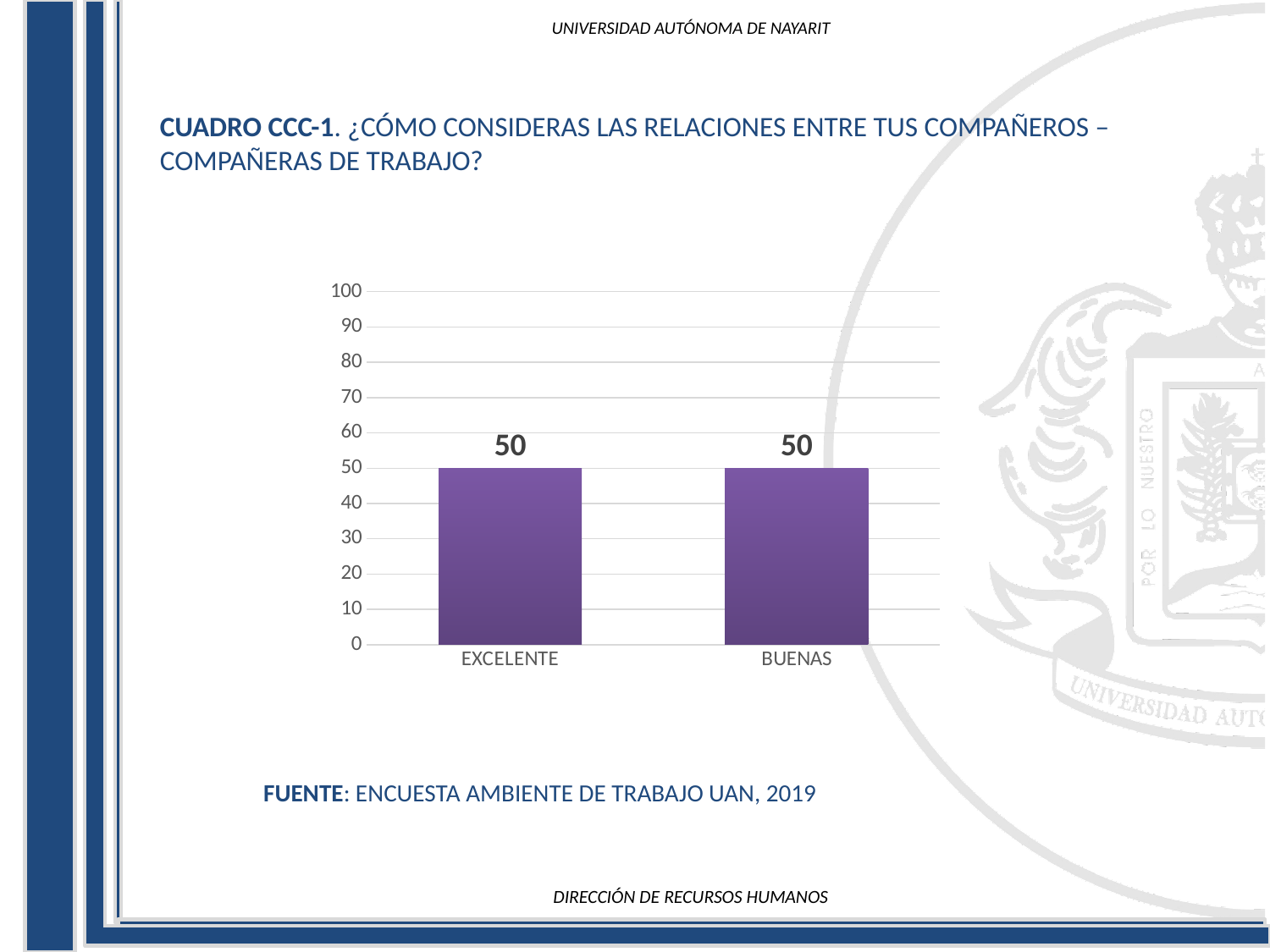
What is the value for BUENAS? 50 What is the maximum value shown on the vertical axis? 100 What source is cited below the chart? ENCUESTA AMBIENTE DE TRABAJO UAN, 2019 What is the difference between the values for EXCELENTE and BUENAS? 0 What is the total of the two bars shown? 100 Is the value for BUENAS greater or less than 40? greater How many categories are shown on the x axis? 2 What is the value for EXCELENTE? 50 Is the value for EXCELENTE greater or less than 60? less What kind of chart is shown on the slide? Bar chart Are the values for EXCELENTE and BUENAS equal? Yes